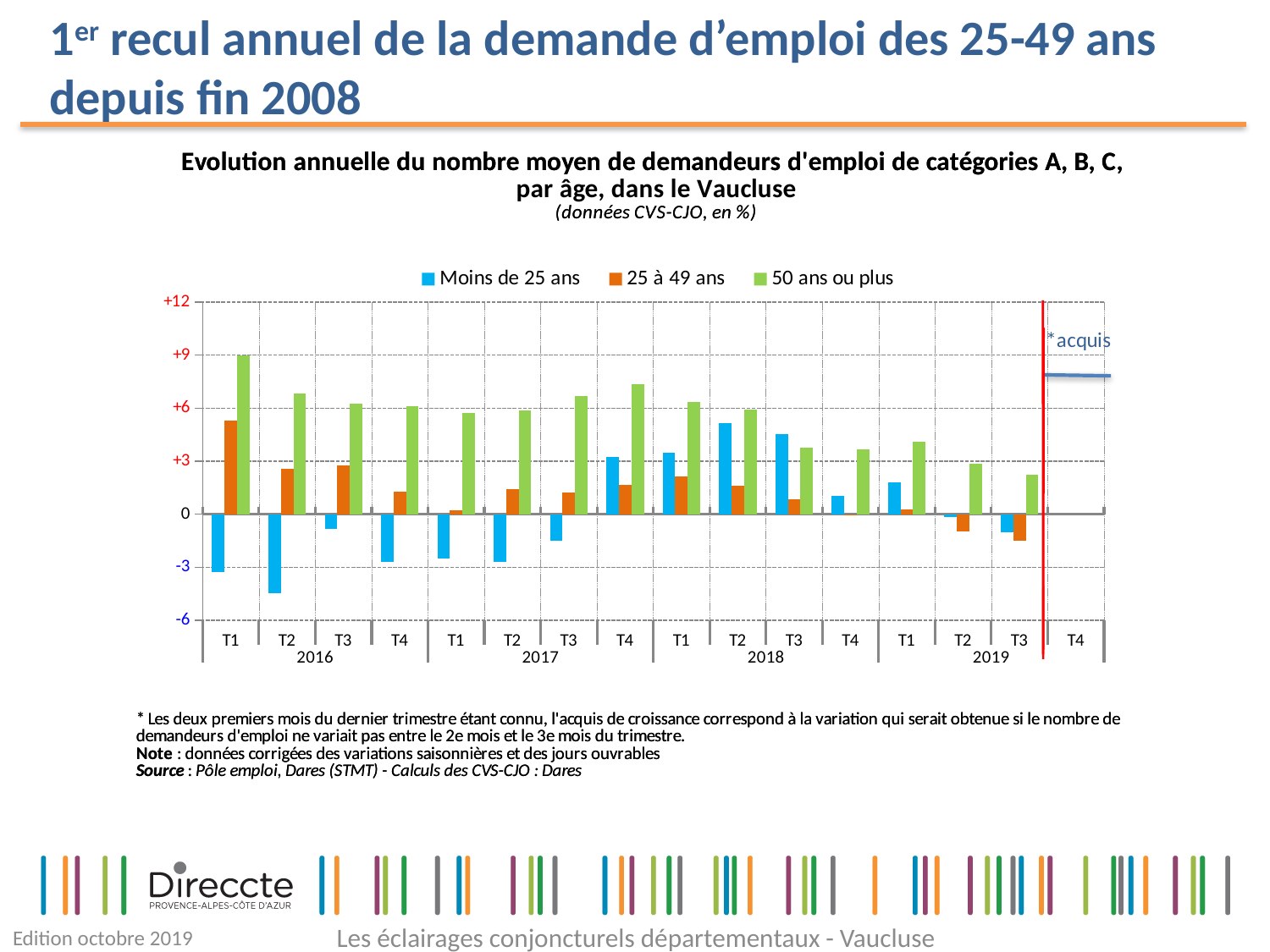
In which quarter does the '50 ans ou plus' series reach its highest value? T1 2016 In which quarter does the 'Moins de 25 ans' series reach its lowest value? T2 2016 Is the value for '50 ans ou plus' in T1 2016 greater or less than +6? greater What are the three series named in the legend? Moins de 25 ans, 25 à 49 ans, 50 ans ou plus How many series does the legend list? 3 Is the value for 'Moins de 25 ans' in T2 2016 greater or less than -3? less Is the value for 'Moins de 25 ans' in T2 2018 greater or less than +3? greater Does the '50 ans ou plus' series rise or fall from T1 2016 to T1 2017? fall How many years are labelled along the x axis? 4 What kind of chart is shown on the slide? bar chart In T1 2016, which is larger: the value for '25 à 49 ans' or for '50 ans ou plus'? 50 ans ou plus In which quarter does the '25 à 49 ans' series reach its highest value? T1 2016